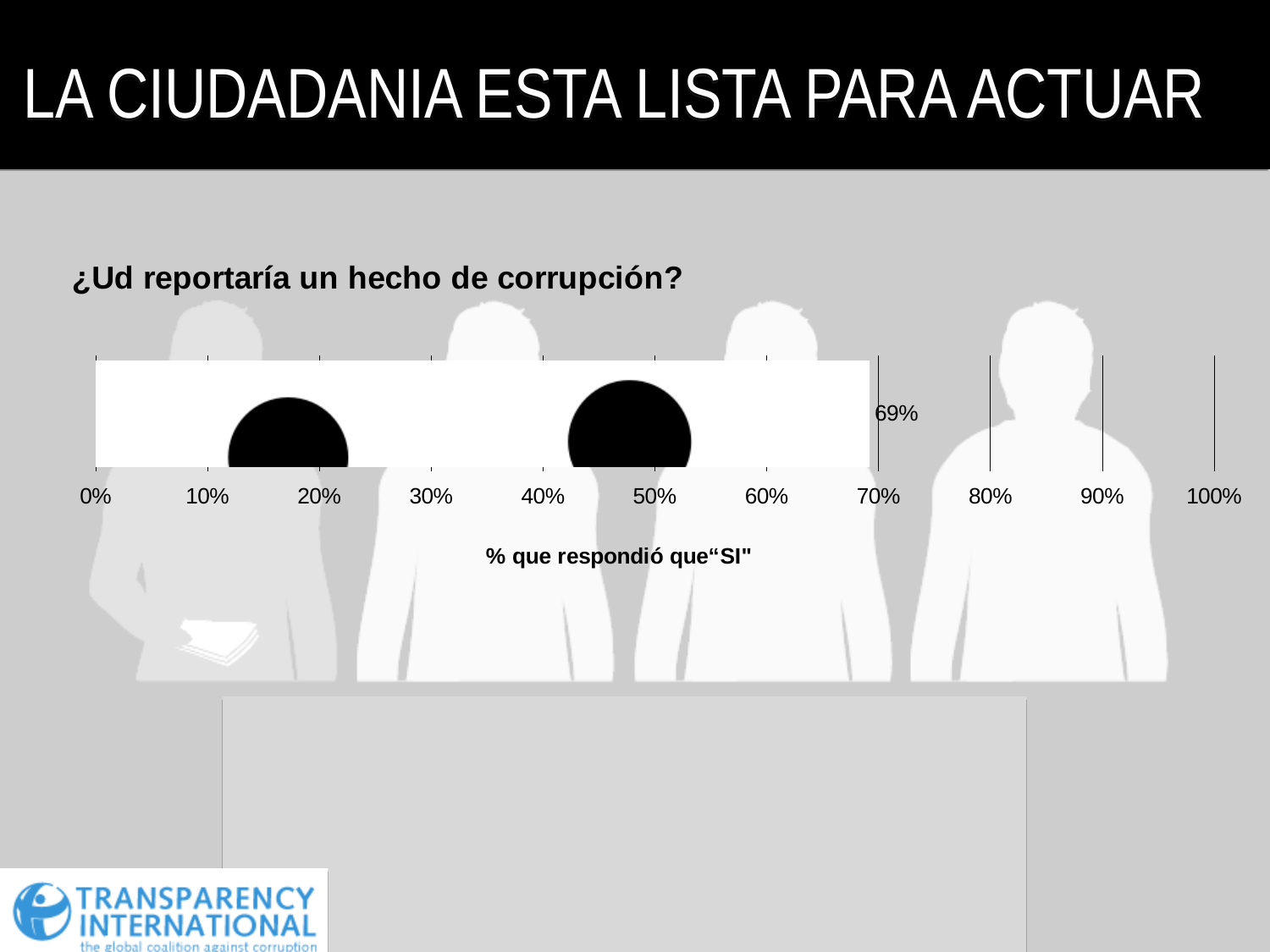
What is the highest value shown on the horizontal axis of the chart? 100% Is the value of the bar in the chart greater or less than 50%? greater What kind of chart is shown on the slide? bar chart Is the value of the bar in the chart greater or less than 70%? less What is the title of the chart on the slide? ¿Ud reportaría un hecho de corrupción? What percentage of respondents answered "SI" to the question "¿Ud reportaría un hecho de corrupción?" according to the chart? 69% What is the label of the horizontal axis of the chart? % que respondió que"SI" How many bars are plotted in the chart? 1 Is the value of the bar in the chart greater or less than 60%? greater Is the bar in the chart oriented horizontally or vertically? horizontally